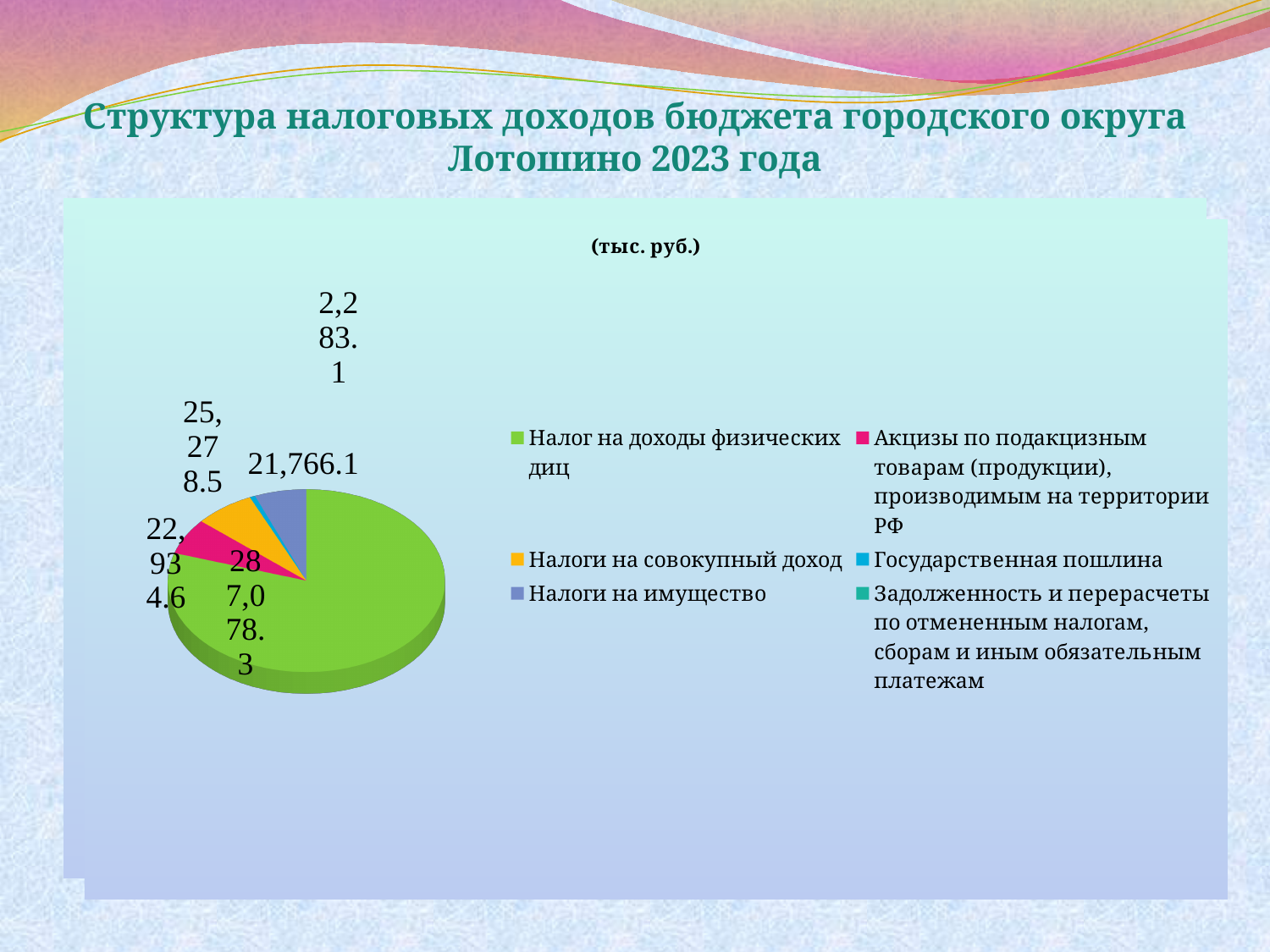
What value is shown for Государственная пошлина? 2,283.1 What is the difference between Налог на доходы физических лиц and Акцизы по подакцизным товарам? 264,143.7 What value is shown for Налоги на совокупный доход? 25,278.5 How many entries does the legend list? 6 What value is shown for Налог на доходы физических лиц? 287,078.3 Which labelled category has the smallest value in the pie chart? Государственная пошлина What kind of chart is shown on the slide? Pie chart Which category has the largest value in the pie chart? Налог на доходы физических лиц What value is shown for Налоги на имущество? 21,766.1 Which is larger: Налоги на совокупный доход or Налоги на имущество? Налоги на совокупный доход What is the difference between Налоги на совокупный доход and Налоги на имущество? 3,512.4 What value is shown for Акцизы по подакцизным товарам (продукции), производимым на территории РФ? 22,934.6